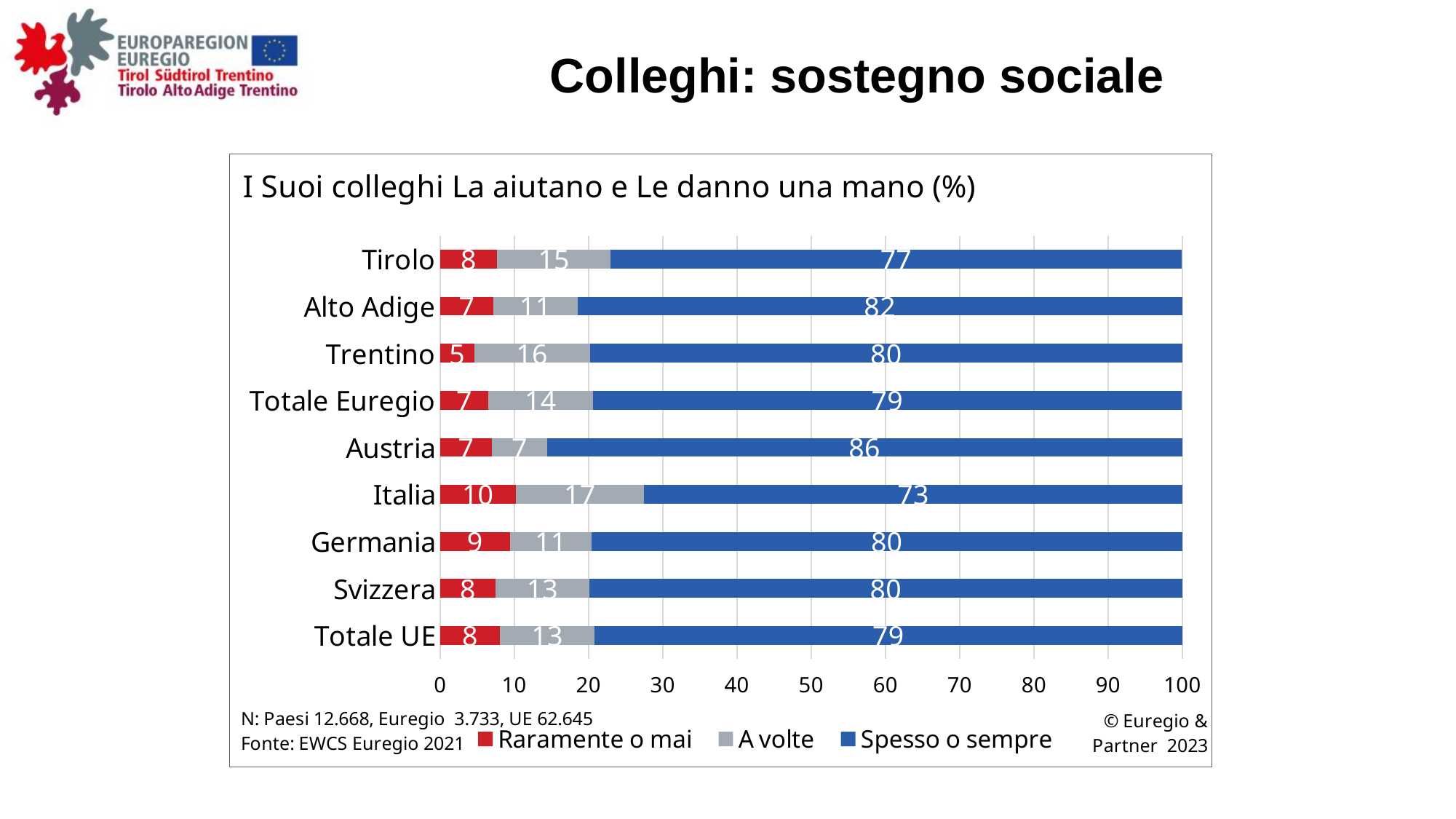
What is the difference between the "Spesso o sempre" values for Alto Adige and Tirolo? 5 Which category has the lowest value for "Spesso o sempre"? Italia Which category has the lowest value for "Raramente o mai"? Trentino How many categories are shown on the chart? 9 What is the value of "Spesso o sempre" for Austria? 86 What is the value of "A volte" for Trentino? 16 Which is larger, the "A volte" value for Italia or for Germania? Italia How many series does the legend list? 3 What is the total of the stacked bar for Totale Euregio? 100 Which category has the highest value for "Spesso o sempre"? Austria What kind of chart is shown on the slide? Stacked bar chart What is the value of "Raramente o mai" for Italia? 10